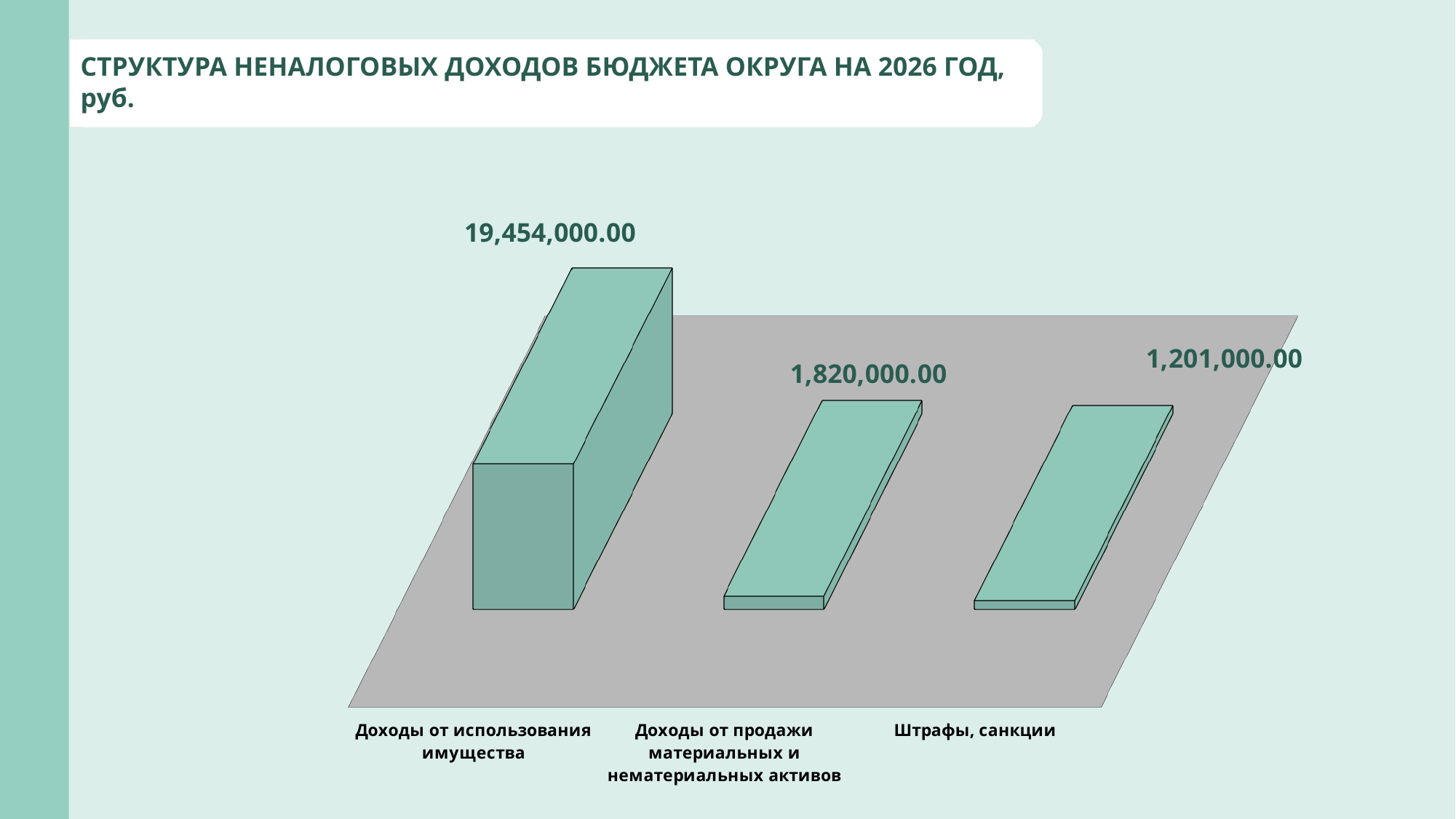
Which is larger: the value for Доходы от продажи материальных и нематериальных активов or the value for Штрафы, санкции? Доходы от продажи материальных и нематериальных активов What is the value for Доходы от продажи материальных и нематериальных активов? 1,820,000.00 Do the values rise or fall from left to right across the categories? fall What is the value for Штрафы, санкции? 1,201,000.00 What is the title of the chart? СТРУКТУРА НЕНАЛОГОВЫХ ДОХОДОВ БЮДЖЕТА ОКРУГА НА 2026 ГОД, руб. What kind of chart is shown on the slide? bar chart Which category has the lowest value? Штрафы, санкции What is the value for Доходы от использования имущества? 19,454,000.00 Which category has the highest value? Доходы от использования имущества What is the difference between the values for Доходы от использования имущества and Доходы от продажи материальных и нематериальных активов? 17,634,000.00 What is the difference between the values for Доходы от продажи материальных и нематериальных активов and Штрафы, санкции? 619,000.00 How many categories are shown in the chart? 3